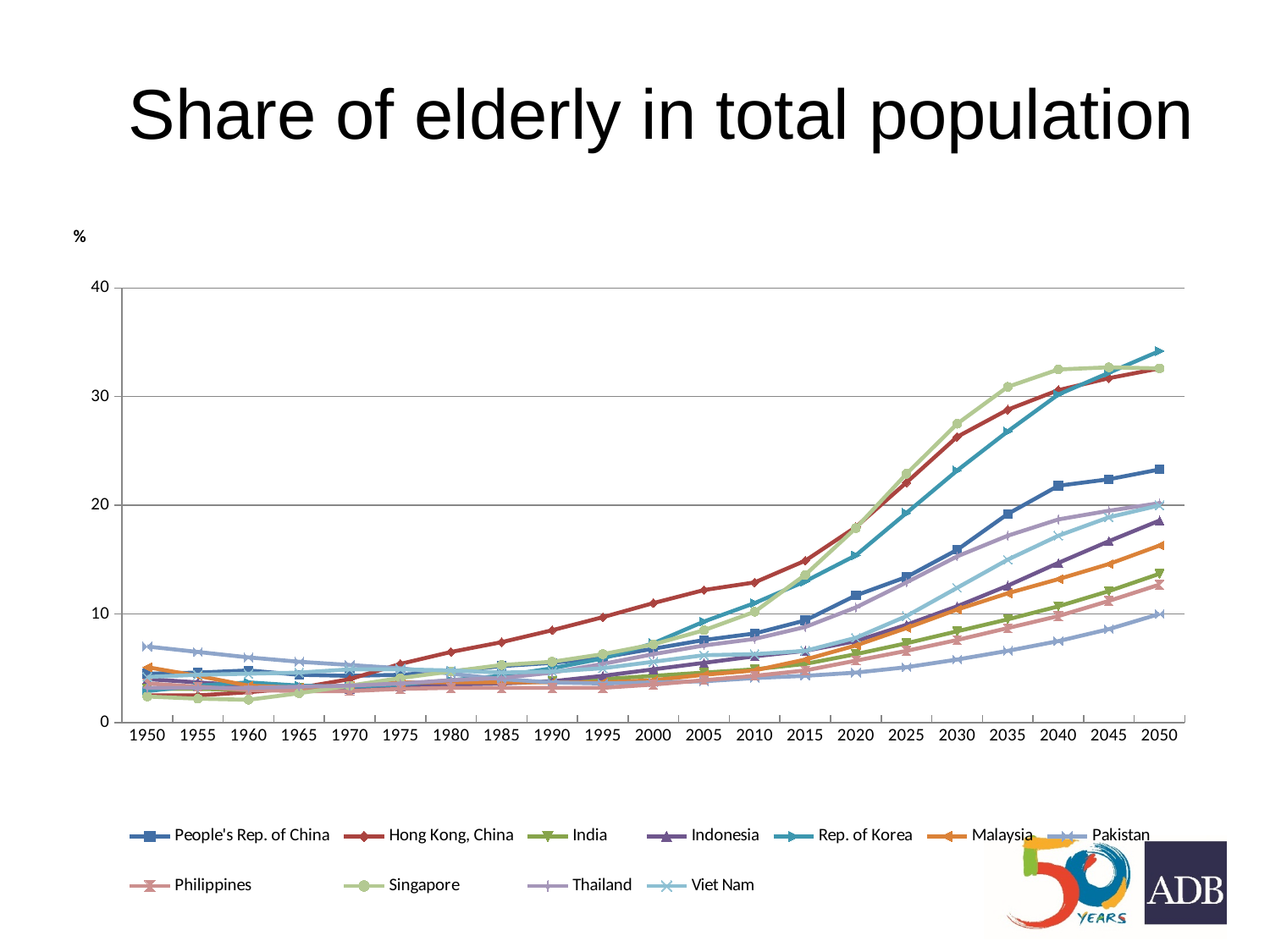
Is the value for People's Rep. of China in 2050 greater or less than 20? greater How many series does the legend list? 11 Which series has the highest value in 2050? Rep. of Korea Is the value for India in 2050 greater or less than 20? less Which series has the highest value in 1950? Pakistan What is the title of the chart? Share of elderly in total population What kind of chart is shown on the slide? line chart In 2050, which is larger: the value for Singapore or the value for India? Singapore Does the value for Hong Kong, China rise or fall from 1970 to 2050? rise Is the value for Rep. of Korea in 2050 greater or less than 30? greater Which series has the lowest value in 2050? Pakistan How many years are marked along the x axis? 21